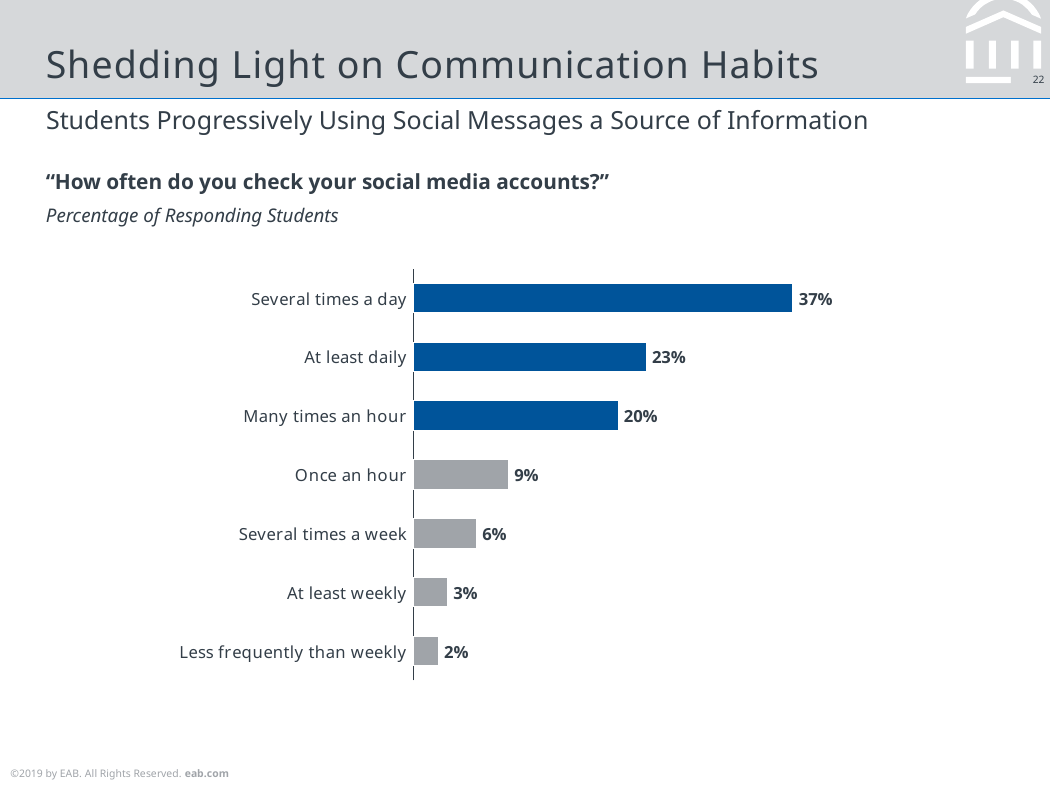
What percentage of responding students check their social media accounts several times a day? 37% Which response category has the lowest percentage of responding students? Less frequently than weekly Which response category has the highest percentage of responding students? Several times a day What percentage of responding students check their social media accounts less frequently than weekly? 2% What survey question is the chart based on? How often do you check your social media accounts? How many response categories are shown in the chart? 7 What kind of chart is shown on the slide? Bar chart What percentage of responding students check their social media accounts at least daily? 23% Which is larger: the percentage for 'Several times a week' or for 'At least weekly'? Several times a week What is the difference in percentage points between 'Many times an hour' and 'Once an hour'? 11 What is the difference in percentage points between 'Several times a day' and 'At least daily'? 14 What percentage of responding students check their social media accounts once an hour? 9%